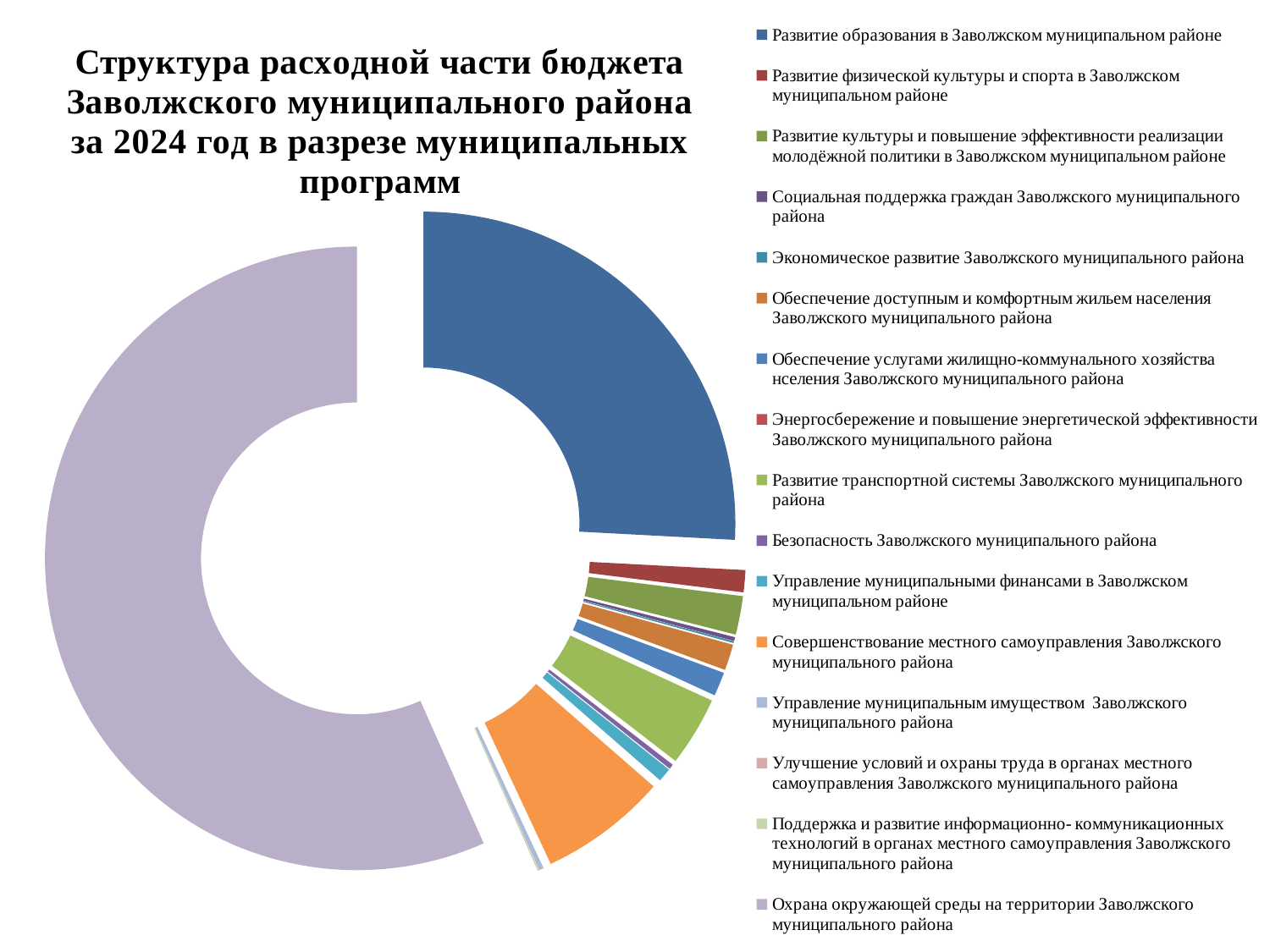
What kind of chart is shown on the slide? Pie chart (doughnut) What is the title of the chart on the slide? Структура расходной части бюджета Заволжского муниципального района за 2024 год в разрезе муниципальных программ Which legend entry is the first one listed in the chart legend? Развитие образования в Заволжском муниципальном районе Which year does the chart title say the budget expenditure structure refers to? 2024 Which of the two slices is larger: 'Развитие образования в Заволжском муниципальном районе' or 'Развитие физической культуры и спорта в Заволжском муниципальном районе'? Развитие образования в Заволжском муниципальном районе Which of the two slices is larger: 'Совершенствование местного самоуправления Заволжского муниципального района' or 'Развитие транспортной системы Заволжского муниципального района'? Совершенствование местного самоуправления Заволжского муниципального района Which of the two slices is larger: 'Развитие образования в Заволжском муниципальном районе' or 'Совершенствование местного самоуправления Заволжского муниципального района'? Развитие образования в Заволжском муниципальном районе How many entries does the chart legend list? 16